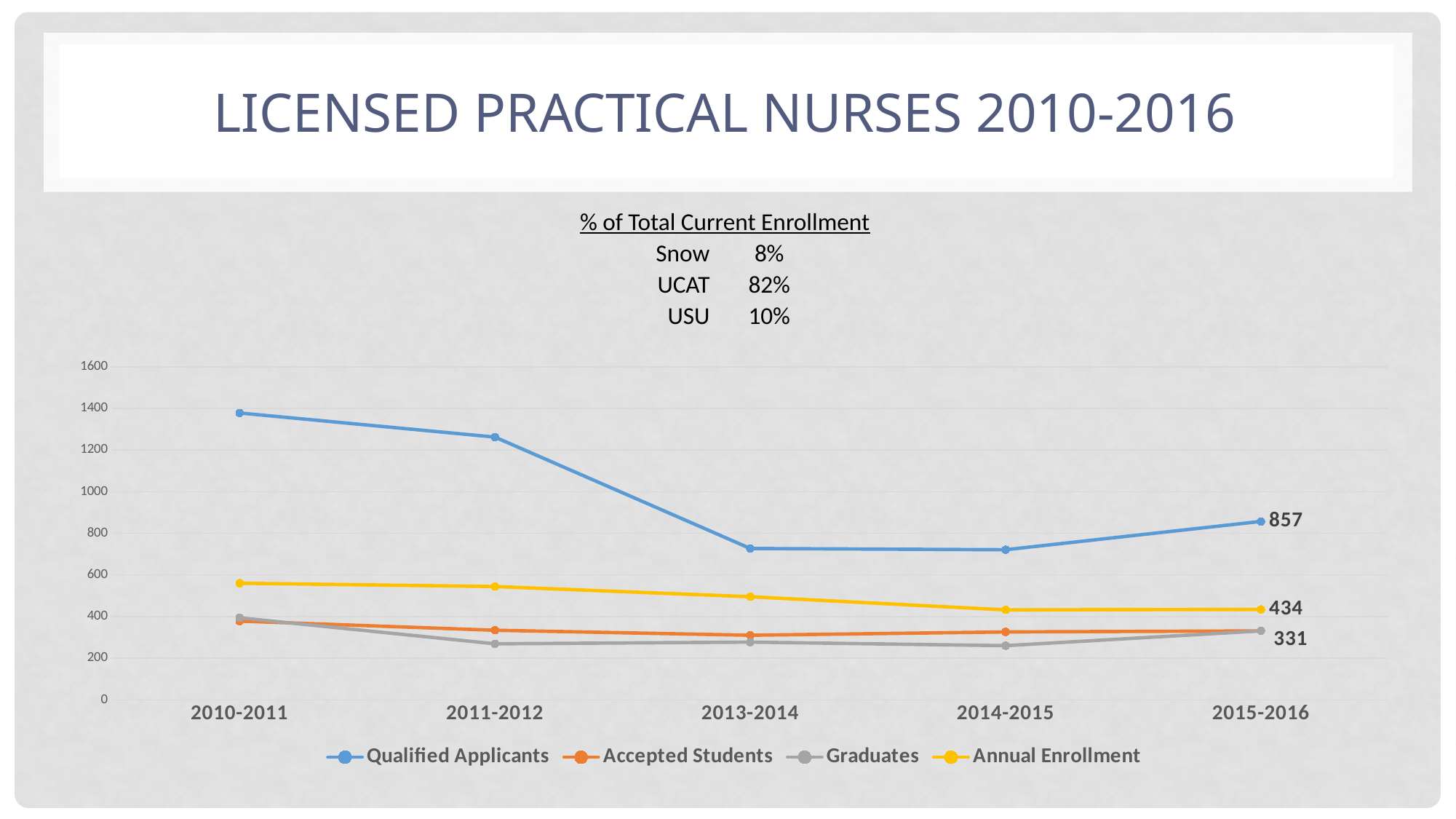
How many series does the chart legend list? 4 Do Qualified Applicants rise or fall from 2010-2011 to 2014-2015? fall What is the value of Qualified Applicants in 2015-2016? 857 Is the value for Qualified Applicants in 2013-2014 greater or less than 800? less What kind of chart is shown on the slide? line chart Is the value for Annual Enrollment in 2010-2011 greater or less than 400? greater What is the value of Annual Enrollment in 2015-2016? 434 How many academic years are shown along the x axis? 5 Is the value for Qualified Applicants in 2010-2011 greater or less than 1200? greater Which series has the highest value in 2010-2011? Qualified Applicants What colour is the Annual Enrollment line in the chart? yellow What is the difference between Qualified Applicants and Annual Enrollment in 2015-2016? 423